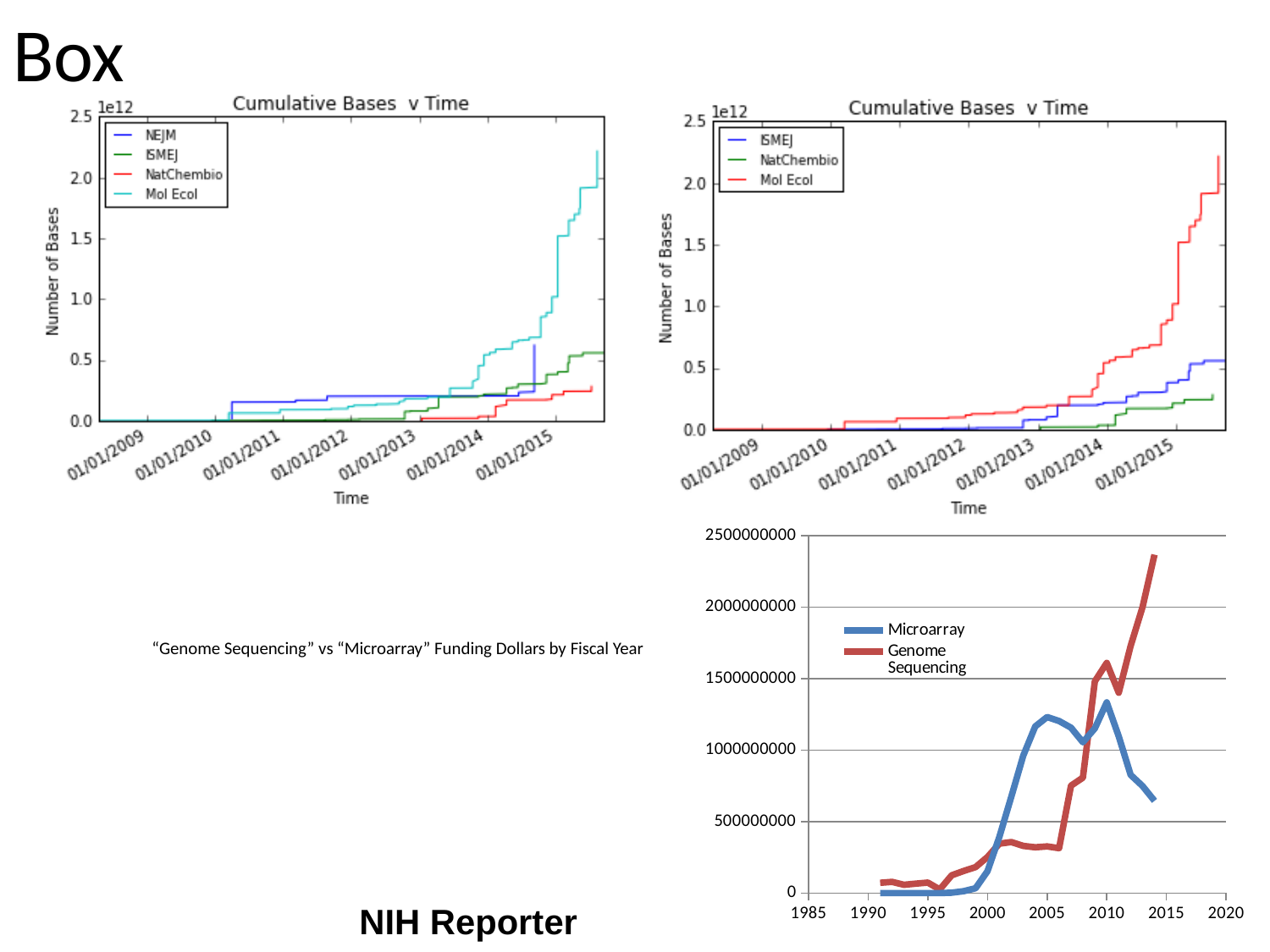
What kind of chart is the bottom-right chart titled "Genome Sequencing" vs "Microarray" Funding Dollars by Fiscal Year? Line chart In the top-left Cumulative Bases v Time chart, which series reaches the highest number of bases by the end of the time range? Mol Ecol In the top-right Cumulative Bases v Time chart, which series reaches the highest number of bases by the end of the time range? Mol Ecol In the bottom-right funding chart, does the Genome Sequencing series generally rise or fall from 2005 to 2014? rise In the bottom-right funding chart, is the Genome Sequencing value in 2014 greater or less than 2000000000? greater In the top-left Cumulative Bases v Time chart, is the final value for Mol Ecol greater or less than 2.0 (x1e12)? greater In the bottom-right funding chart, is the Microarray value in 2014 greater or less than 1000000000? less In the bottom-right funding chart, which series has the larger value in 2005, Microarray or Genome Sequencing? Microarray How many series does the legend of the top-left Cumulative Bases v Time chart list? 4 How many series does the legend of the top-right Cumulative Bases v Time chart list? 3 How many series does the legend of the bottom-right funding chart list? 2 What is the y-axis label of the top-left Cumulative Bases v Time chart? Number of Bases